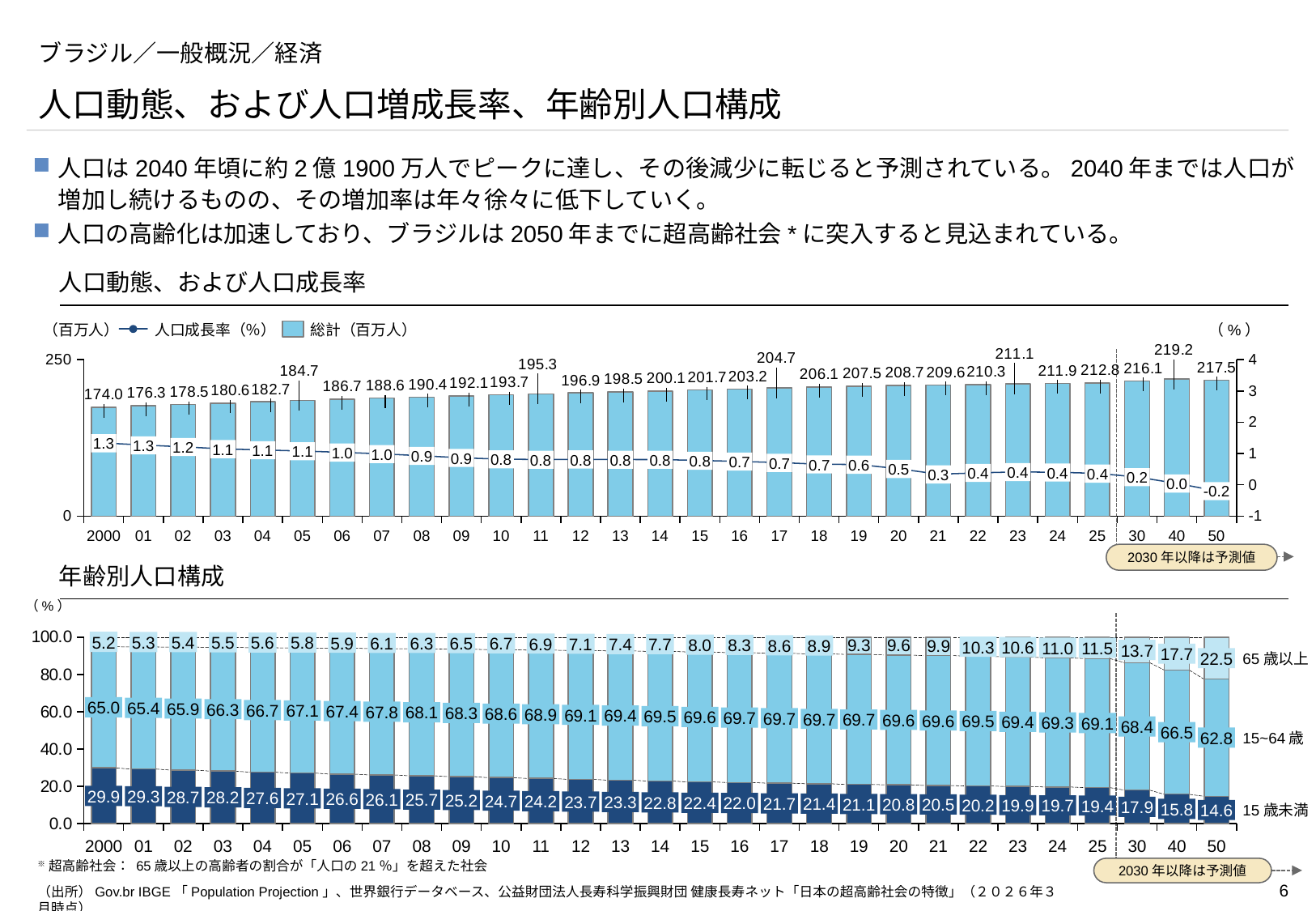
In the bottom chart (年齢別人口構成), what is the value for 65歳以上 in 2050? 22.5 In the bottom chart (年齢別人口構成), which is larger in 2050: 15歳未満 or 65歳以上? 65歳以上 In the top chart (人口動態、および人口成長率), is the total population for 2011 greater or less than 200? less In the top chart (人口動態、および人口成長率), does the population growth rate rise or fall from 2000 to 2050? fall In the top chart (人口動態、および人口成長率), which year has the highest total population? 2040 In the bottom chart (年齢別人口構成), what is the difference between the 65歳以上 value in 2050 and in 2000? 17.3 In the top chart (人口動態、および人口成長率), how many series does the legend list? 2 In the bottom chart (年齢別人口構成), what is the value for 15歳未満 in 2000? 29.9 In the top chart (人口動態、および人口成長率), what is the total population (総計) for 2000? 174.0 In the top chart (人口動態、および人口成長率), what is the population growth rate (人口成長率) for 2050? -0.2 In the top chart (人口動態、および人口成長率), what is the difference in total population between 2040 and 2000? 45.2 What kind of chart is the bottom chart (年齢別人口構成)? stacked bar chart